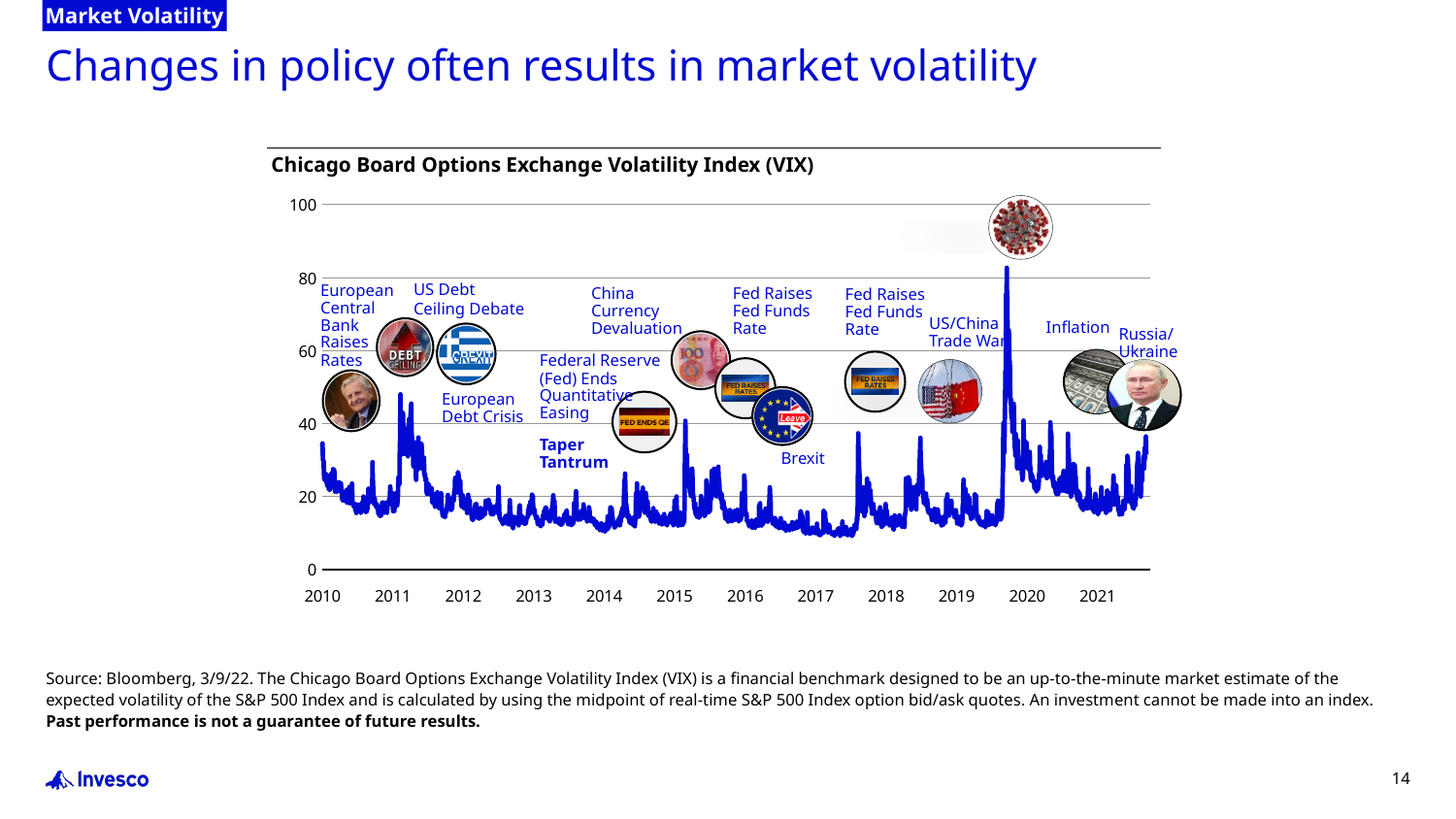
What is the last year labelled on the x axis? 2021 How many year labels are shown on the x axis? 12 What kind of chart is shown on the slide? Line chart How many lines are plotted on the chart? 1 What is the title of the chart? Chicago Board Options Exchange Volatility Index (VIX) Is the peak value of the VIX in 2020 greater or less than 60? greater Which is higher on the chart: the VIX peak in 2020 or the VIX peak in 2011? 2020 In which year does the VIX reach its highest peak on the chart? 2020 Is the VIX level during 2013 greater or less than 40? less What is the first year shown on the x axis? 2010 What is the highest value shown on the y axis? 100 Is the VIX level during 2017 greater or less than 40? less